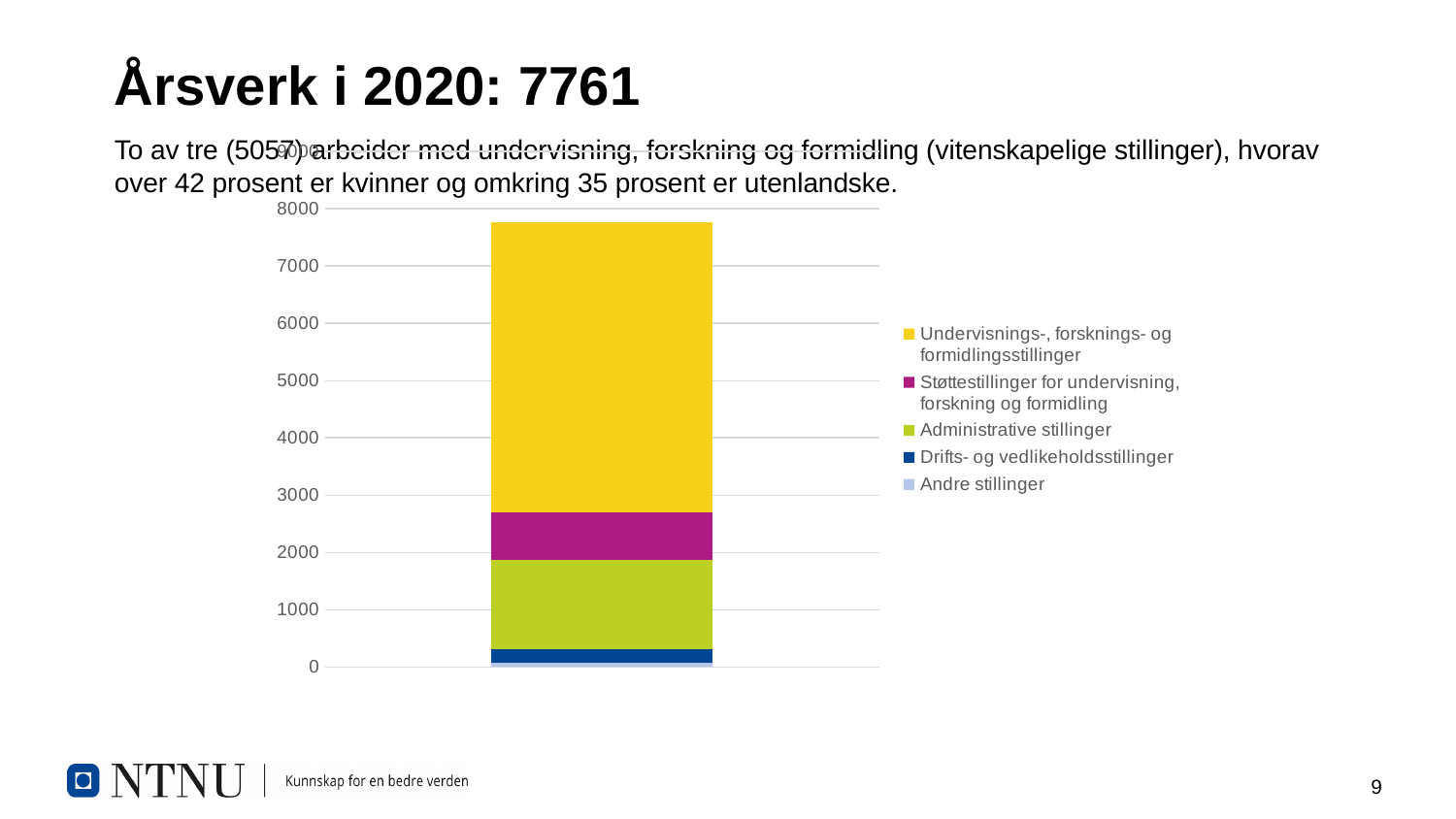
Which series makes up the largest segment of the stacked bar? Undervisnings-, forsknings- og formidlingsstillinger How many bars are plotted in the chart? 1 Which segment is larger: Administrative stillinger or Støttestillinger for undervisning, forskning og formidling? Administrative stillinger Is the total height of the stacked bar greater or less than 7000? greater Which series makes up the smallest segment of the stacked bar? Andre stillinger How many series does the legend list? 5 What kind of chart is shown on the slide? Stacked bar chart Is the segment for Administrative stillinger greater or less than 1000? greater Is the total height of the stacked bar greater or less than 8000? less What colour represents Administrative stillinger in the chart? Green According to the slide title, what is the total number of årsverk in 2020 represented by the stacked bar? 7761